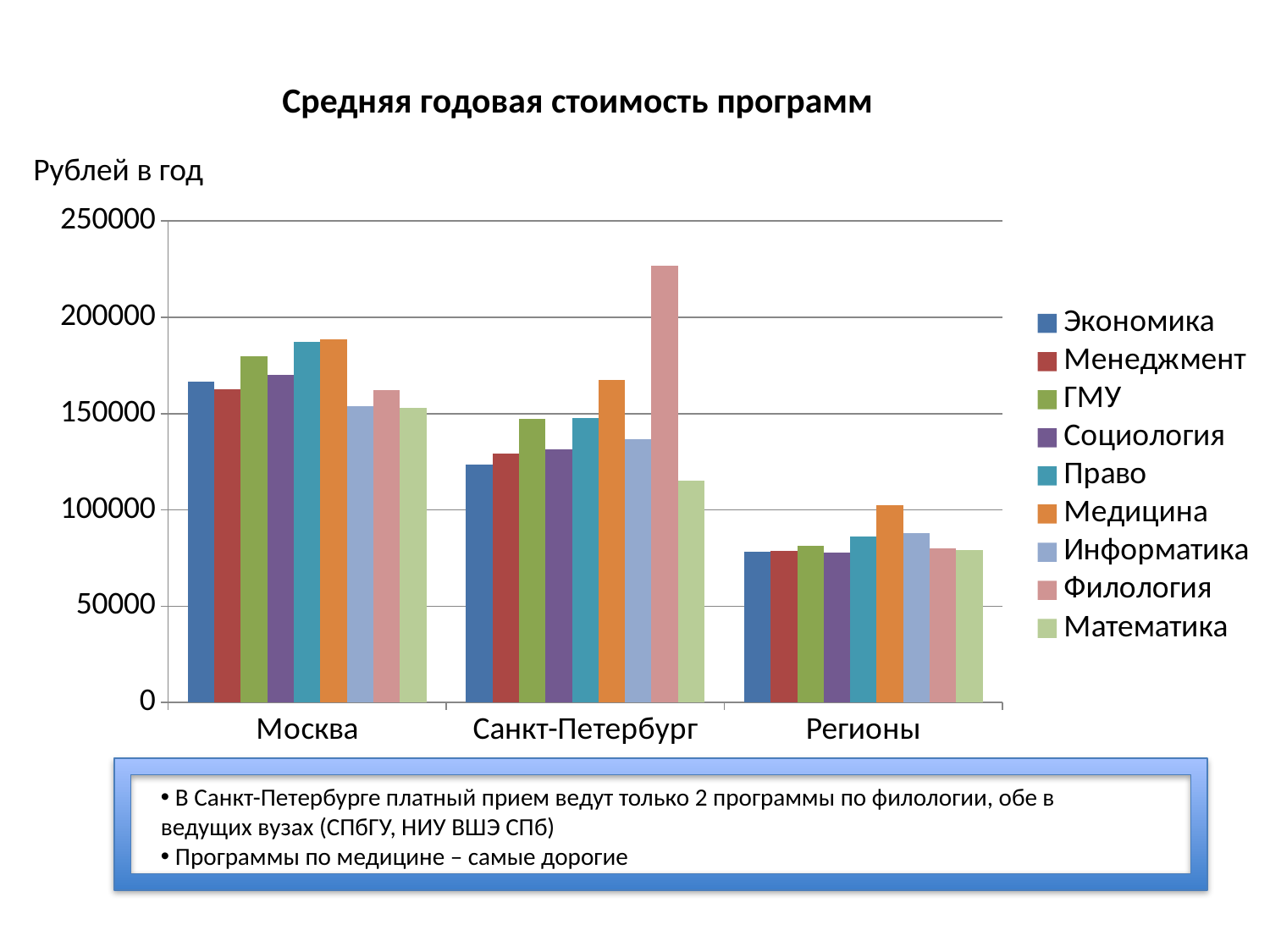
Is the value for Филология in Санкт-Петербург greater or less than 200000? greater Which programme has the lowest value for Санкт-Петербург? Математика Which is larger: the value for Медицина in Москва or the value for Медицина in Санкт-Петербург? Москва Do the values for Экономика rise or fall from Москва to Регионы along the x axis? fall How many series does the legend list? 9 Is the value for Право in Регионы greater or less than 100000? less What is the title of the chart? Средняя годовая стоимость программ Is the value for Математика in Санкт-Петербург greater or less than 100000? greater How many categories are shown on the x axis? 3 What kind of chart is shown on the slide? Bar chart Which programme has the highest value for Санкт-Петербург? Филология Which programme has the highest value for Регионы? Медицина